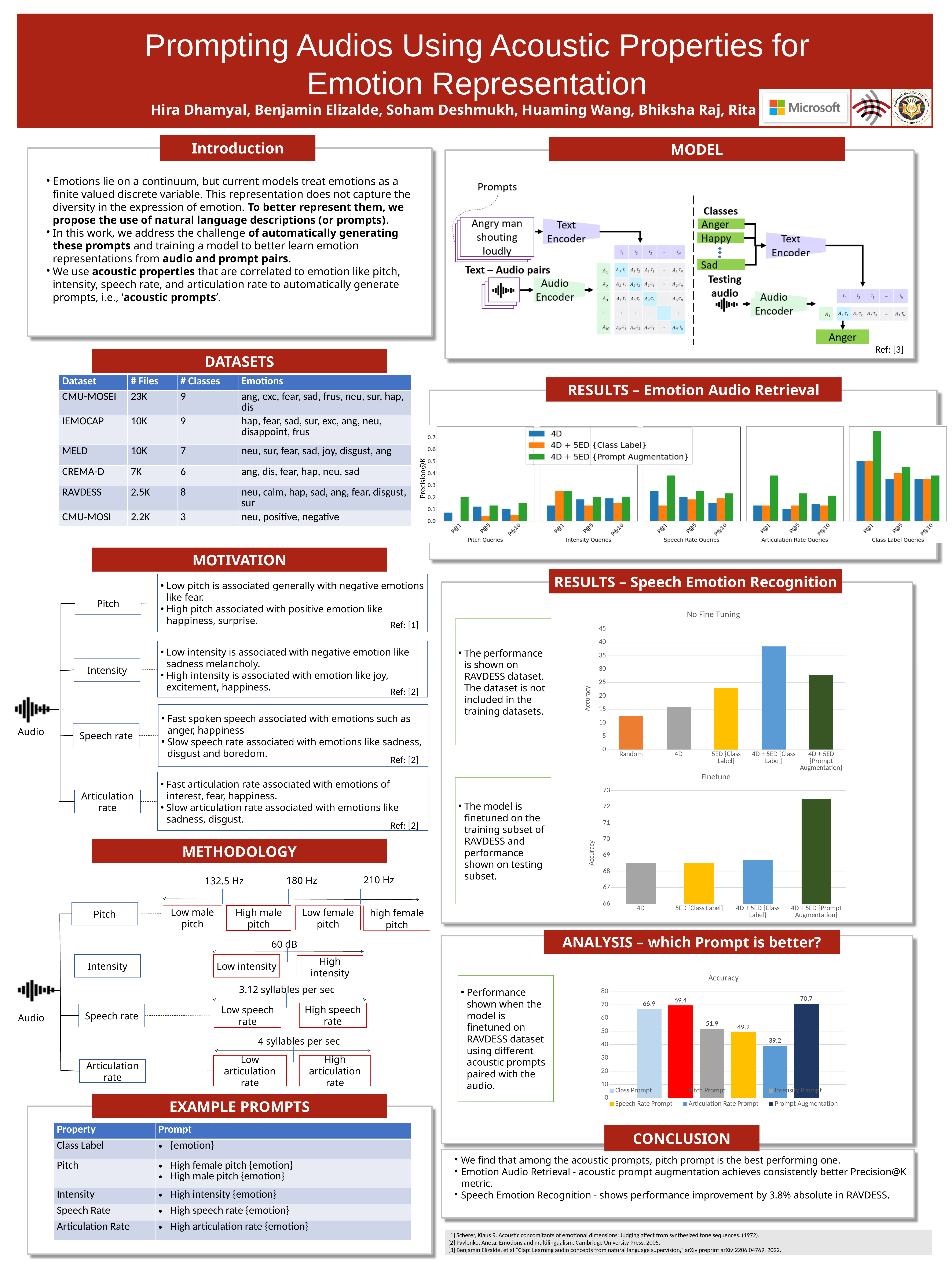
In the 'Accuracy' chart under 'ANALYSIS – which Prompt is better?', what is the difference between Pitch Prompt and Class Prompt? 2.5 In the 'No Fine Tuning' chart, is the value for Random greater or less than 15? less In the 'Accuracy' chart under 'ANALYSIS – which Prompt is better?', what is the value for Articulation Rate Prompt? 39.2 In the 'Accuracy' chart under 'ANALYSIS – which Prompt is better?', which prompt has the lowest accuracy? Articulation Rate Prompt In the 'Accuracy' chart under 'ANALYSIS – which Prompt is better?', how many entries does the legend list? 6 In the 'No Fine Tuning' chart, which category has the highest accuracy? 4D + 5ED {Class Label} In the 'No Fine Tuning' chart, how many categories are shown on the x axis? 5 In the 'RESULTS – Emotion Audio Retrieval' chart, how many series does the legend list? 3 In the 'Finetune' chart, is the value for 4D + 5ED {Prompt Augmentation} greater or less than 72? greater In the 'Accuracy' chart under 'ANALYSIS – which Prompt is better?', what is the value for Pitch Prompt? 69.4 In the 'Finetune' chart, which category has the highest accuracy? 4D + 5ED {Prompt Augmentation} In the 'Accuracy' chart under 'ANALYSIS – which Prompt is better?', which prompt has the highest accuracy? Prompt Augmentation